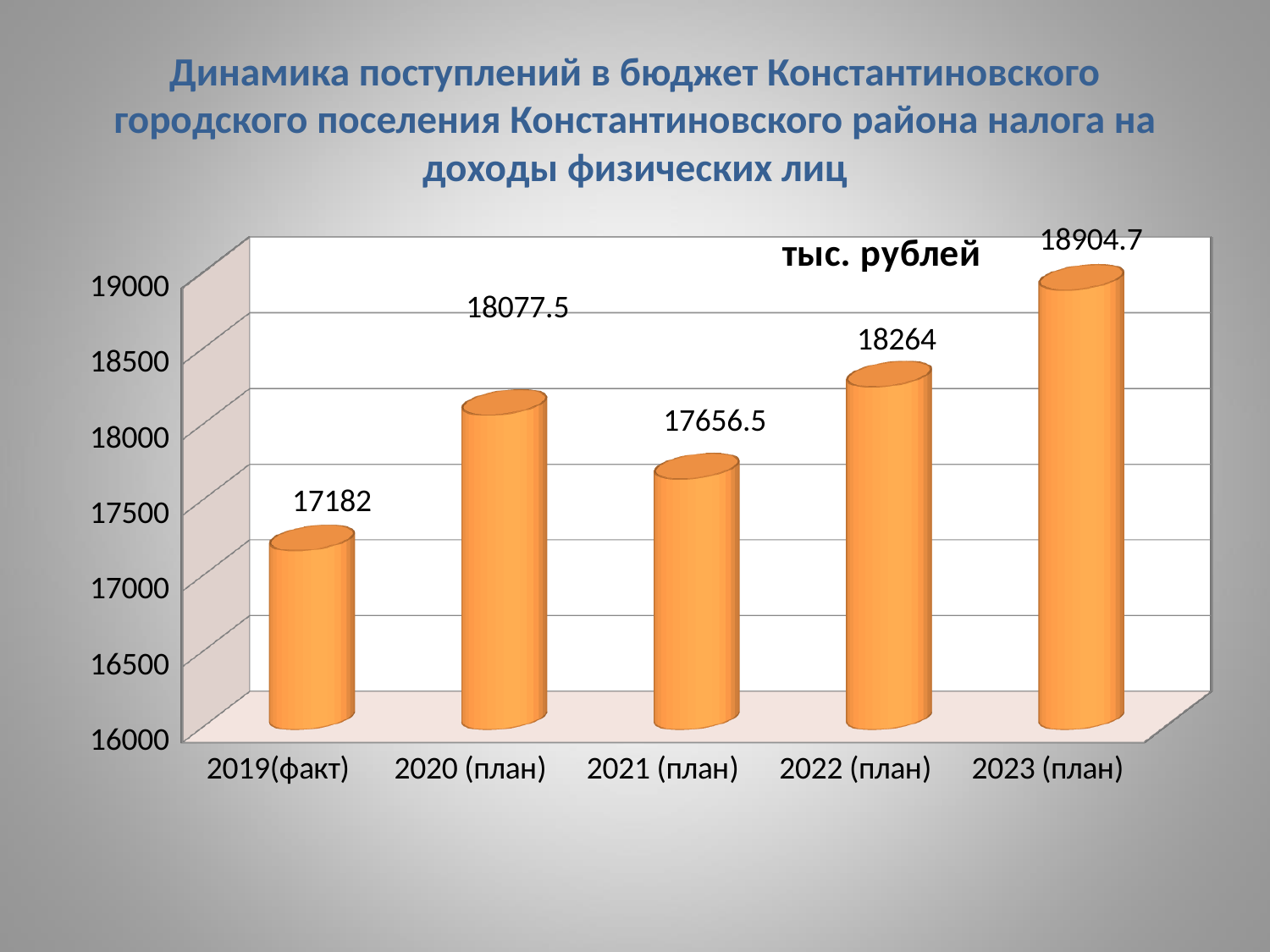
What is the difference between the values for 2020 (план) and 2021 (план)? 421 Is the value for 2022 (план) greater or less than 18000? greater How many categories are shown on the x axis? 5 Which category has the lowest value? 2019(факт) What kind of chart is shown on the slide? bar chart What is the value for 2021 (план)? 17656.5 What is the value for 2023 (план)? 18904.7 What is the difference between the values for 2023 (план) and 2019(факт)? 1722.7 What unit of measurement is indicated on the chart? тыс. рублей What is the value for 2019(факт)? 17182 Which is larger, the value for 2020 (план) or the value for 2022 (план)? 2022 (план) Which category has the highest value? 2023 (план)